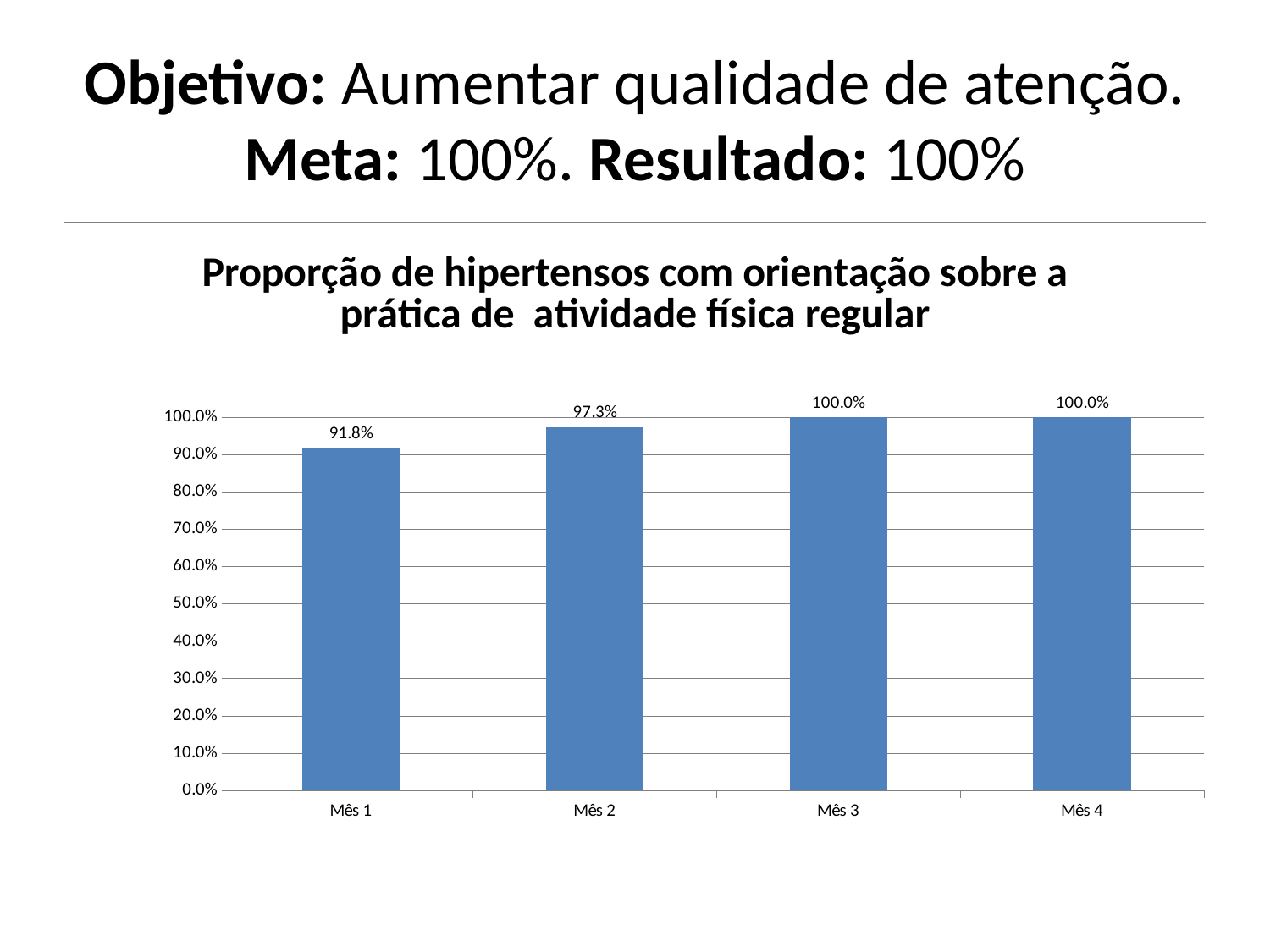
Do the values rise or fall from Mês 1 to Mês 4? rise What is the value for Mês 3? 100.0% What is the value for Mês 1? 91.8% Is the value for Mês 1 greater or less than 90.0%? greater What is the difference between the values for Mês 3 and Mês 2? 2.7% Which is larger, the value for Mês 1 or the value for Mês 2? Mês 2 How many months are shown on the x axis? 4 What is the difference between the values for Mês 2 and Mês 1? 5.5% Which month has the lowest value? Mês 1 What is the title of the chart? Proporção de hipertensos com orientação sobre a prática de atividade física regular What is the value for Mês 2? 97.3% What kind of chart is shown on the slide? bar chart